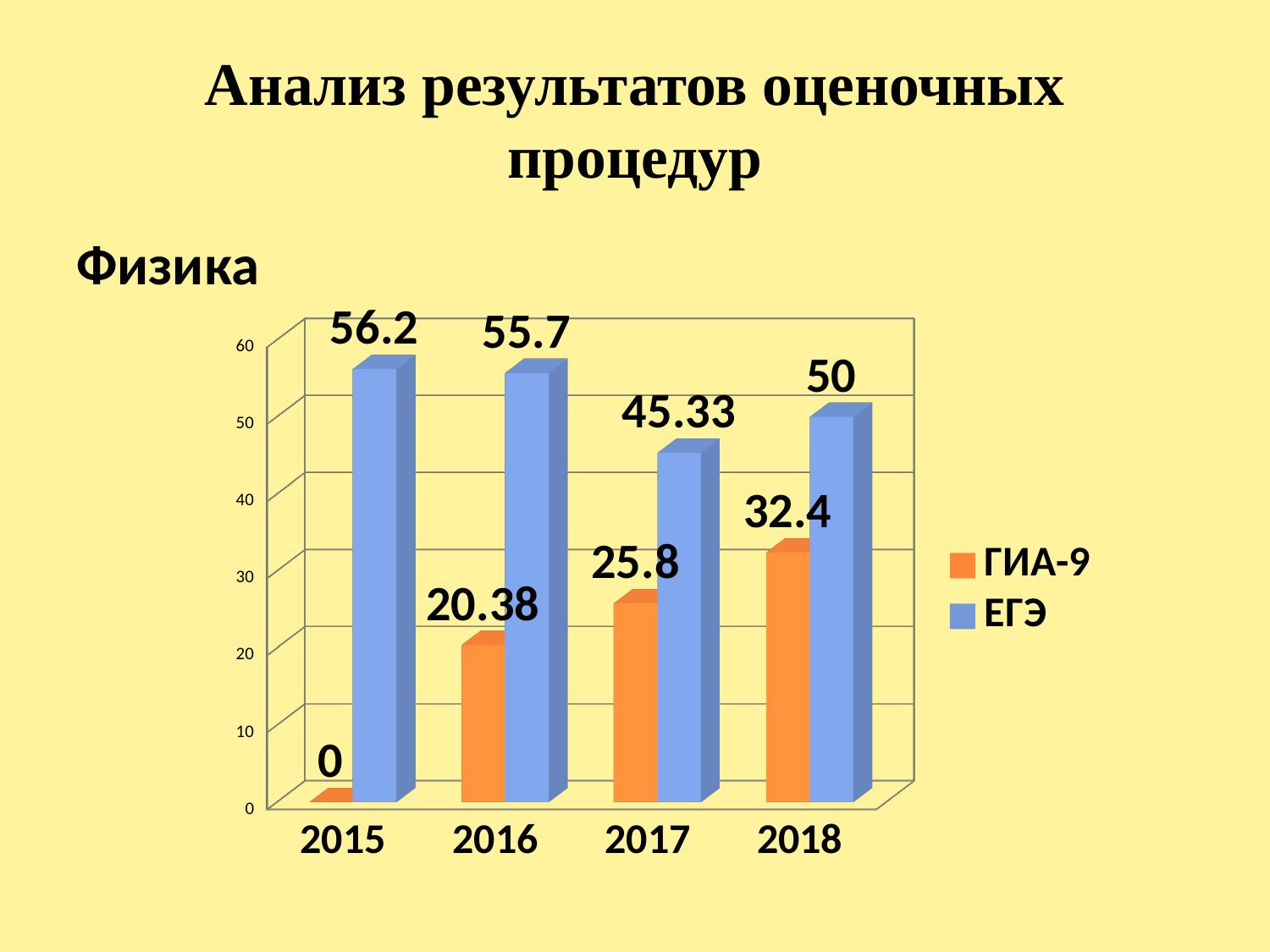
What is the ГИА-9 value for 2016? 20.38 In which year is the ГИА-9 value lowest? 2015 What is the ЕГЭ value for 2018? 50 How many series does the legend list? 2 Do the ГИА-9 values rise or fall from 2015 to 2018? rise Which is larger in 2018, the ГИА-9 value or the ЕГЭ value? ЕГЭ What is the ГИА-9 value for 2015? 0 What is the ЕГЭ value for 2015? 56.2 In which year is the ЕГЭ value highest? 2015 How many years are shown on the x axis? 4 What is the difference between the ЕГЭ and ГИА-9 values in 2017? 19.53 What kind of chart is shown on the slide? bar chart